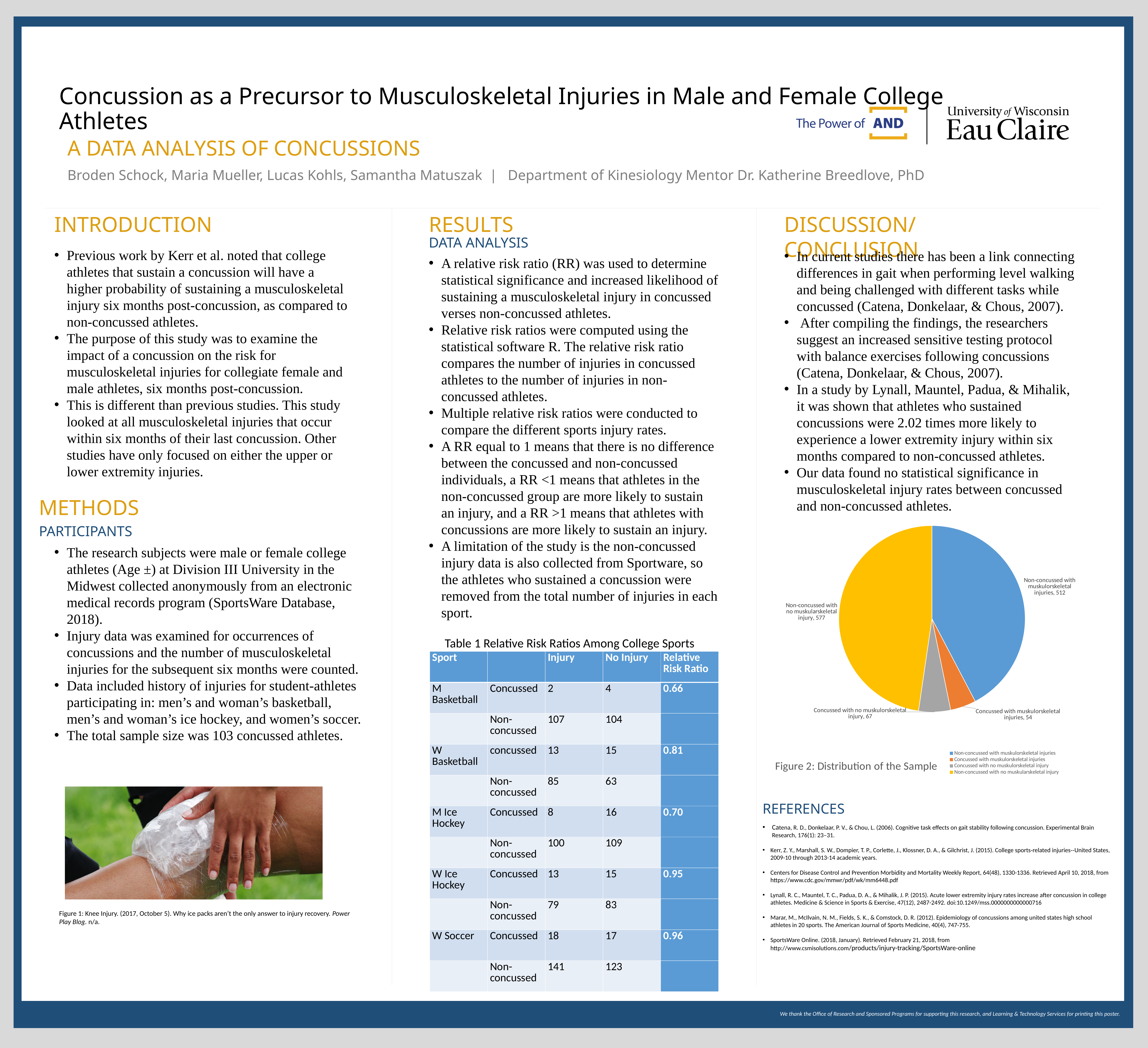
Which category has the smallest slice in the Figure 2 pie chart? Concussed with musculoskeletal injuries Which category has the largest slice in the Figure 2 pie chart? Non-concussed with no musculoskeletal injury How many slices does the pie chart in Figure 2 have? 4 What kind of chart is Figure 2: Distribution of the Sample? pie chart In Figure 2, what is the value for Non-concussed with musculoskeletal injuries? 512 In Figure 2, what is the value for Non-concussed with no musculoskeletal injury? 577 In Figure 2, what is the difference between the Non-concussed with no musculoskeletal injury value and the Non-concussed with musculoskeletal injuries value? 65 What is the total of all four slices in the Figure 2 pie chart? 1210 What colour is the Non-concussed with no musculoskeletal injury slice in Figure 2? yellow In Figure 2, what is the value for Concussed with no musculoskeletal injury? 67 In Figure 2, which is larger: Concussed with no musculoskeletal injury or Concussed with musculoskeletal injuries? Concussed with no musculoskeletal injury In Figure 2, what is the value for Concussed with musculoskeletal injuries? 54